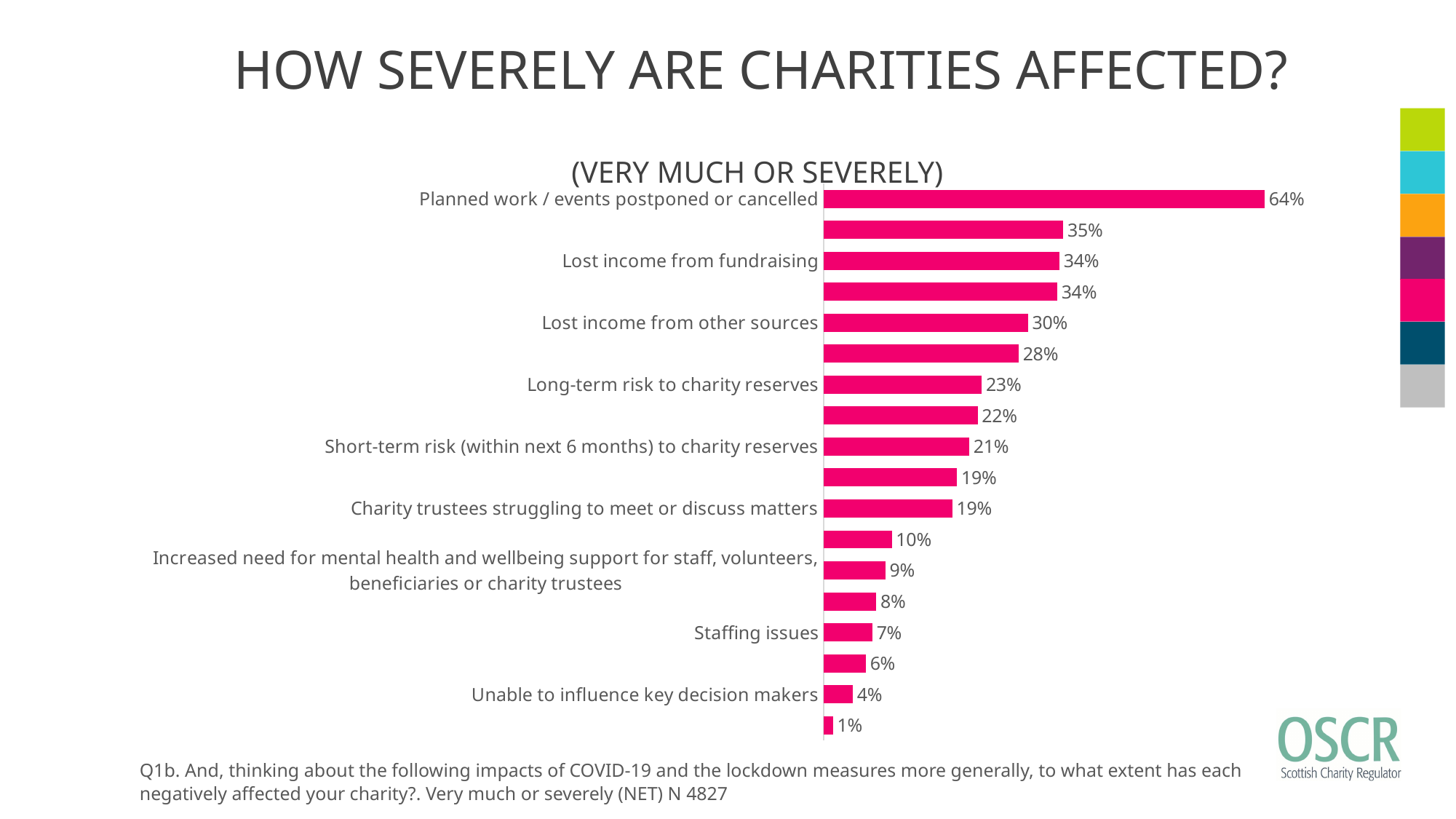
Do the bar values increase or decrease from the top of the chart to the bottom? Decrease What is the value shown for Lost income from other sources? 30% What is the value shown for Unable to influence key decision makers? 4% What is the value shown for Lost income from fundraising? 34% What is the value shown for Staffing issues? 7% What is the difference between the values for Planned work / events postponed or cancelled and Lost income from fundraising? 30 percentage points Which labelled category has the highest value on the chart? Planned work / events postponed or cancelled What percentage of charities reported planned work / events postponed or cancelled as affecting them very much or severely? 64% What type of chart is shown on the slide? Bar chart What is the value shown for Long-term risk to charity reserves? 23% Which is larger: the value for Short-term risk (within next 6 months) to charity reserves or the value for Charity trustees struggling to meet or discuss matters? Short-term risk (within next 6 months) to charity reserves What is the smallest value shown on any bar in the chart? 1%